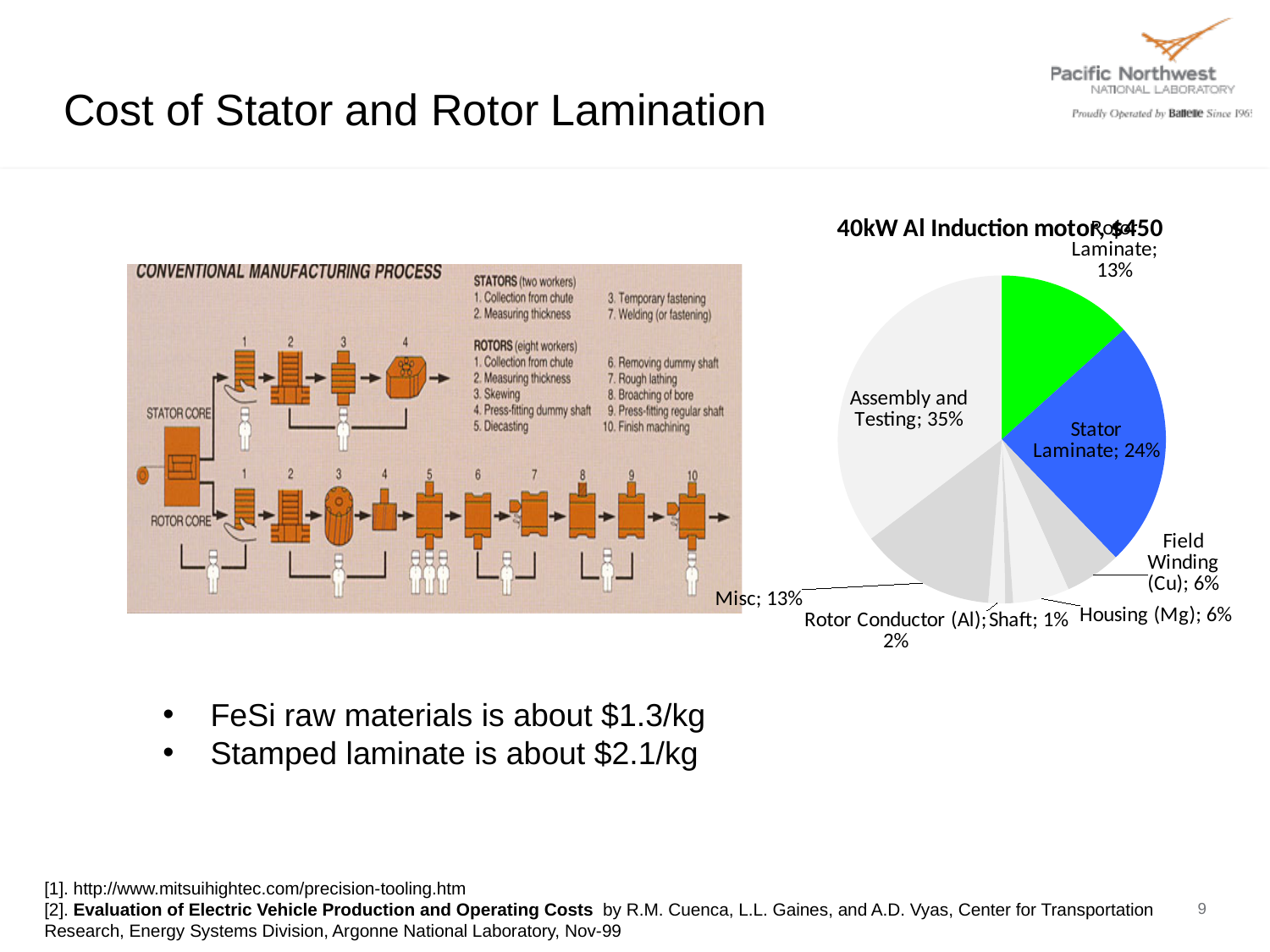
What type of chart is shown on the slide? pie chart What share of the pie does Rotor Conductor (Al) account for? 2% What share of the pie does Stator Laminate account for? 24% What share of the pie does Assembly and Testing account for? 35% Which slice of the pie chart is the largest? Assembly and Testing What share of the pie does Rotor Laminate account for? 13% Which is larger, the share for Field Winding (Cu) or the share for Misc? Misc What is the combined share of Stator Laminate and Rotor Laminate? 37% Which slice of the pie chart is the smallest? Shaft What is the difference in percentage points between Stator Laminate and Rotor Laminate? 11 What share of the pie does Shaft account for? 1% How many slices does the pie chart have? 8